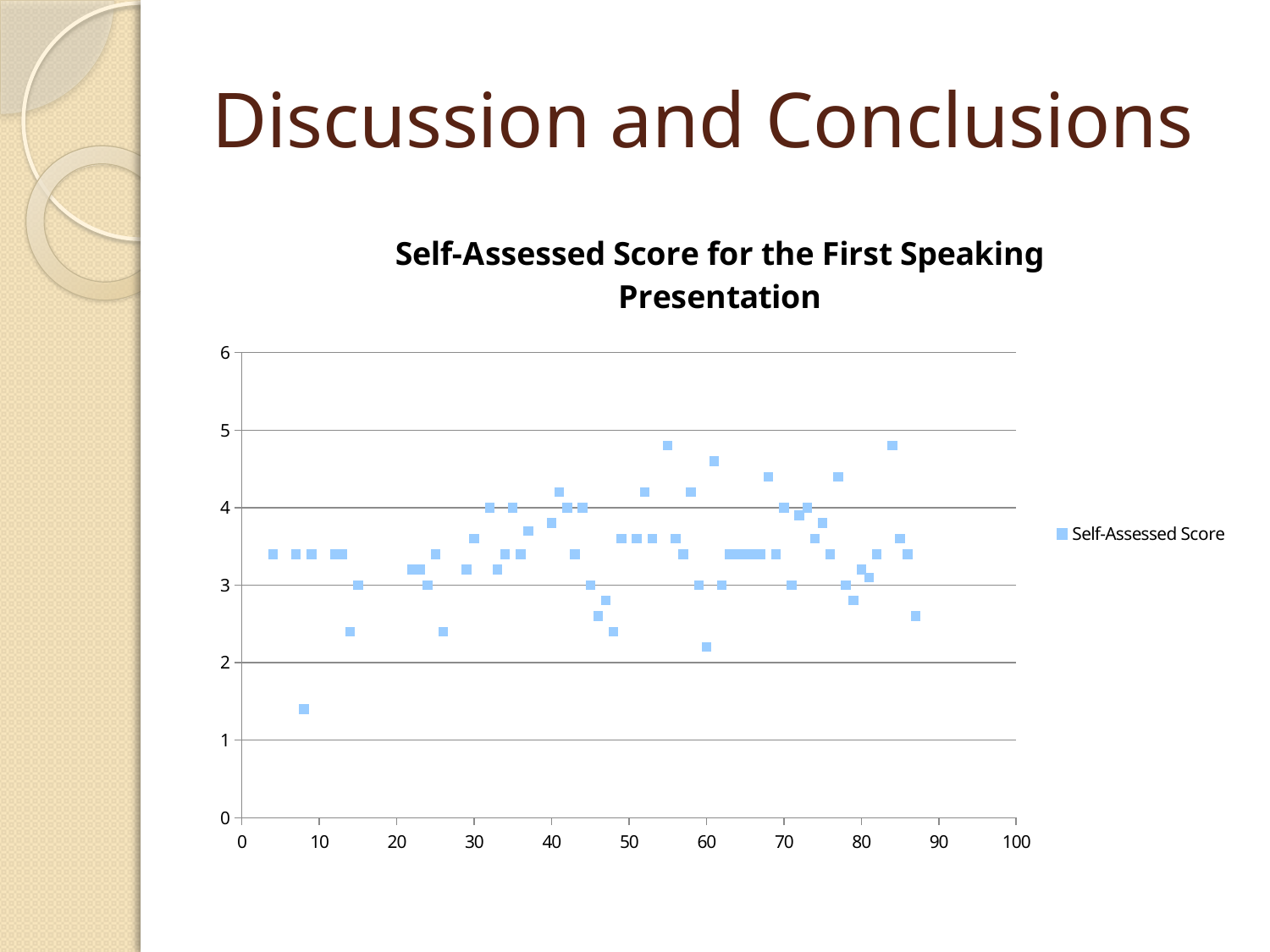
What kind of chart is shown on the slide? scatter chart What is the title of the chart? Self-Assessed Score for the First Speaking Presentation How many series does the legend list? 1 Is the highest plotted point greater or less than 4? greater Is the lowest plotted point greater or less than 1? greater What is the maximum value shown on the vertical axis? 6 Is the highest plotted point greater or less than 5? less What is the name of the series shown in the legend? Self-Assessed Score